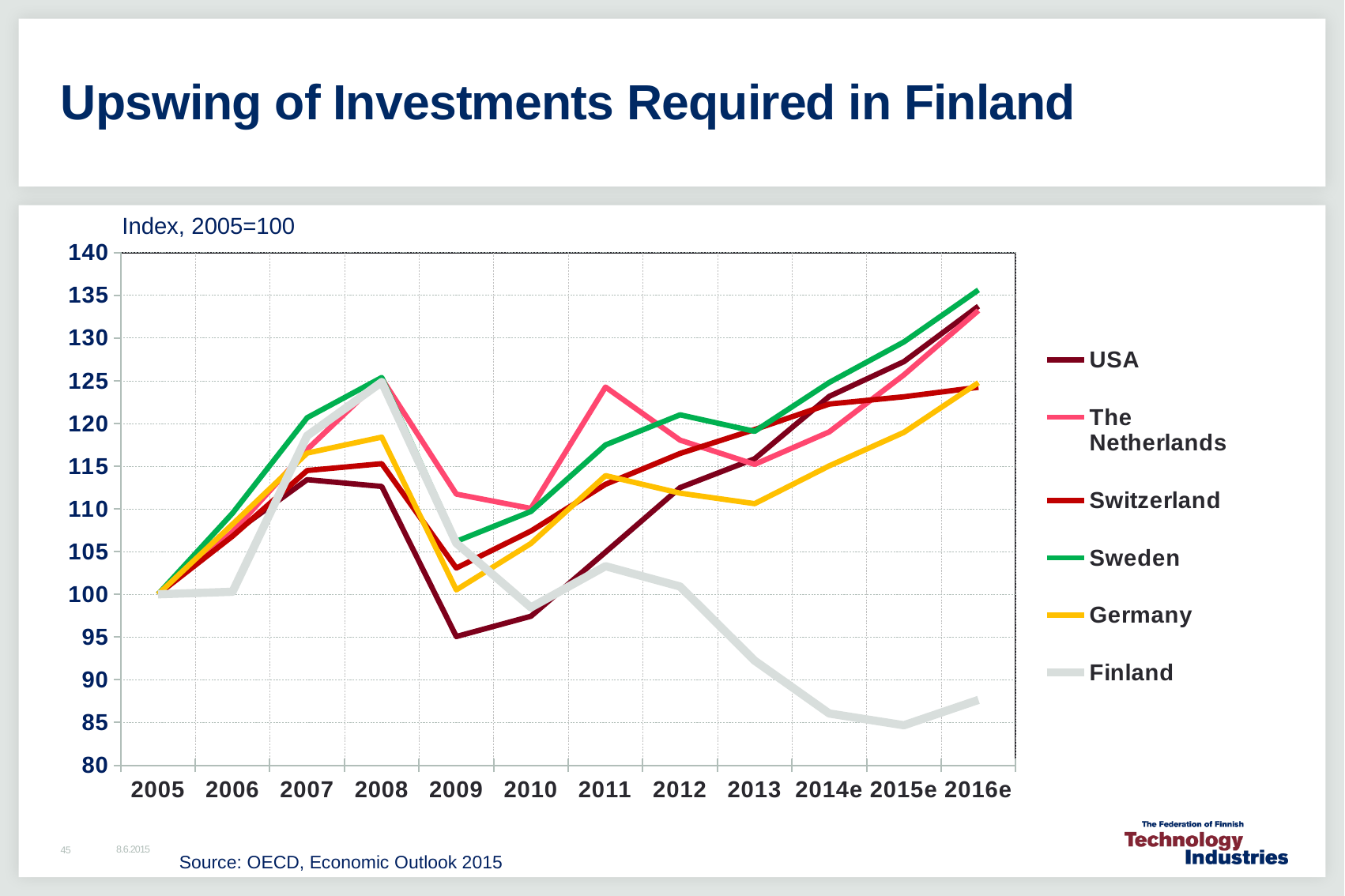
Is the value for Sweden in 2016e greater or less than 130? greater How many series does the legend list? 6 How many years are shown along the x axis? 12 Which country has the highest index value in 2016e? Sweden Which is larger in 2013, the value for Finland or the value for Germany? Germany Is the value for The Netherlands in 2011 greater or less than 120? greater What is the index value for all countries in 2005? 100 Is the value for USA in 2009 greater or less than 100? less Which country has the lowest index value in 2016e? Finland Does the Finland line rise or fall from 2011 to 2015e? fall What kind of chart is shown on the slide? line chart